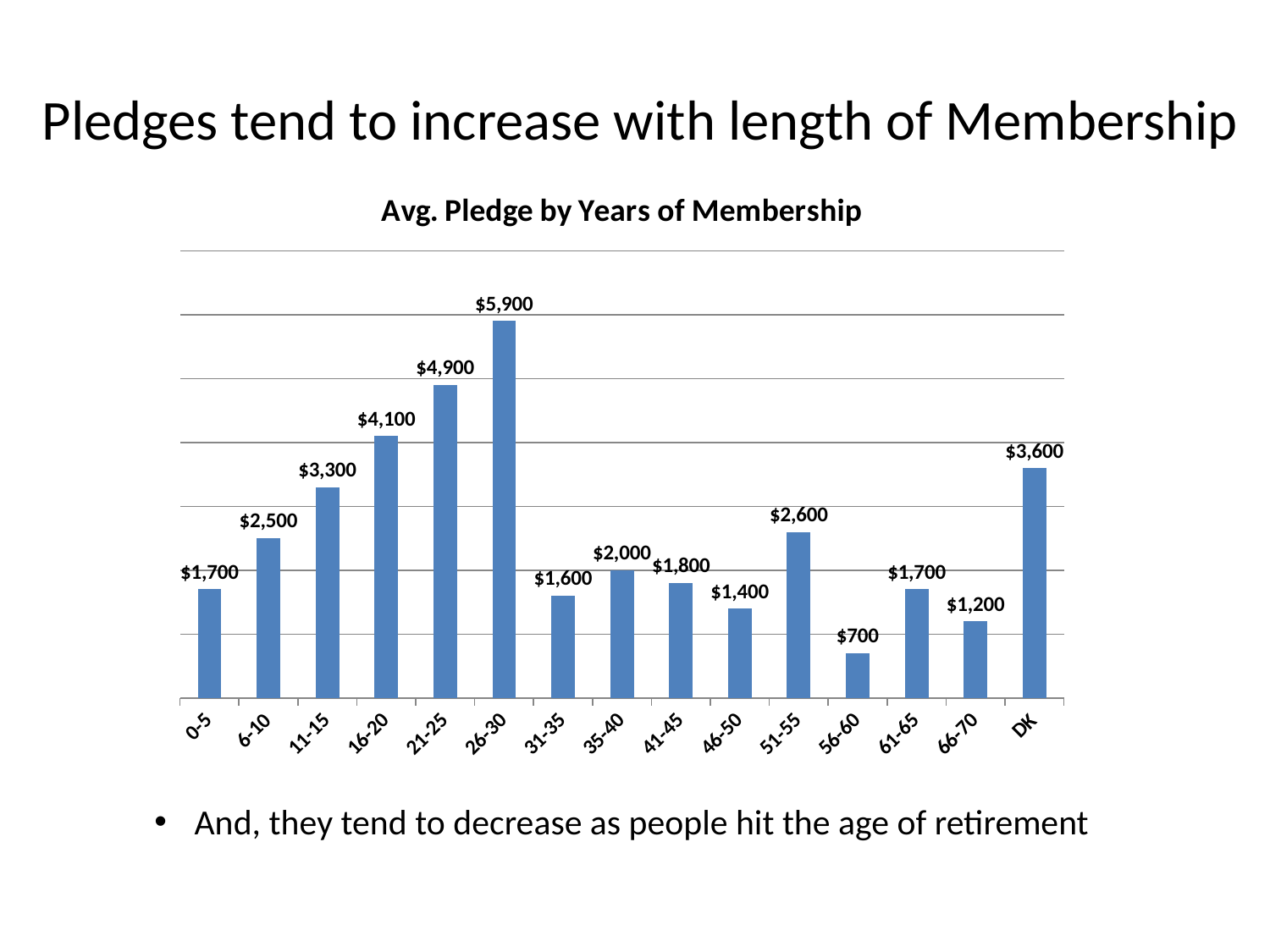
Which years-of-membership category has the lowest average pledge? 56-60 What is the difference between the average pledge for 26-30 years and for 21-25 years? $1,000 What is the average pledge for the 56-60 years category? $700 What is the title of the chart? Avg. Pledge by Years of Membership Which has a larger average pledge, the 35-40 category or the 46-50 category? 35-40 How many years-of-membership categories are shown on the x axis? 15 What is the average pledge for members with 26-30 years of membership? $5,900 Which has a larger average pledge, the 16-20 category or the 11-15 category? 16-20 What is the average pledge for the DK category? $3,600 What kind of chart is shown on the slide? Bar chart What is the difference between the average pledge for 51-55 years and for 56-60 years? $1,900 Which years-of-membership category has the highest average pledge? 26-30